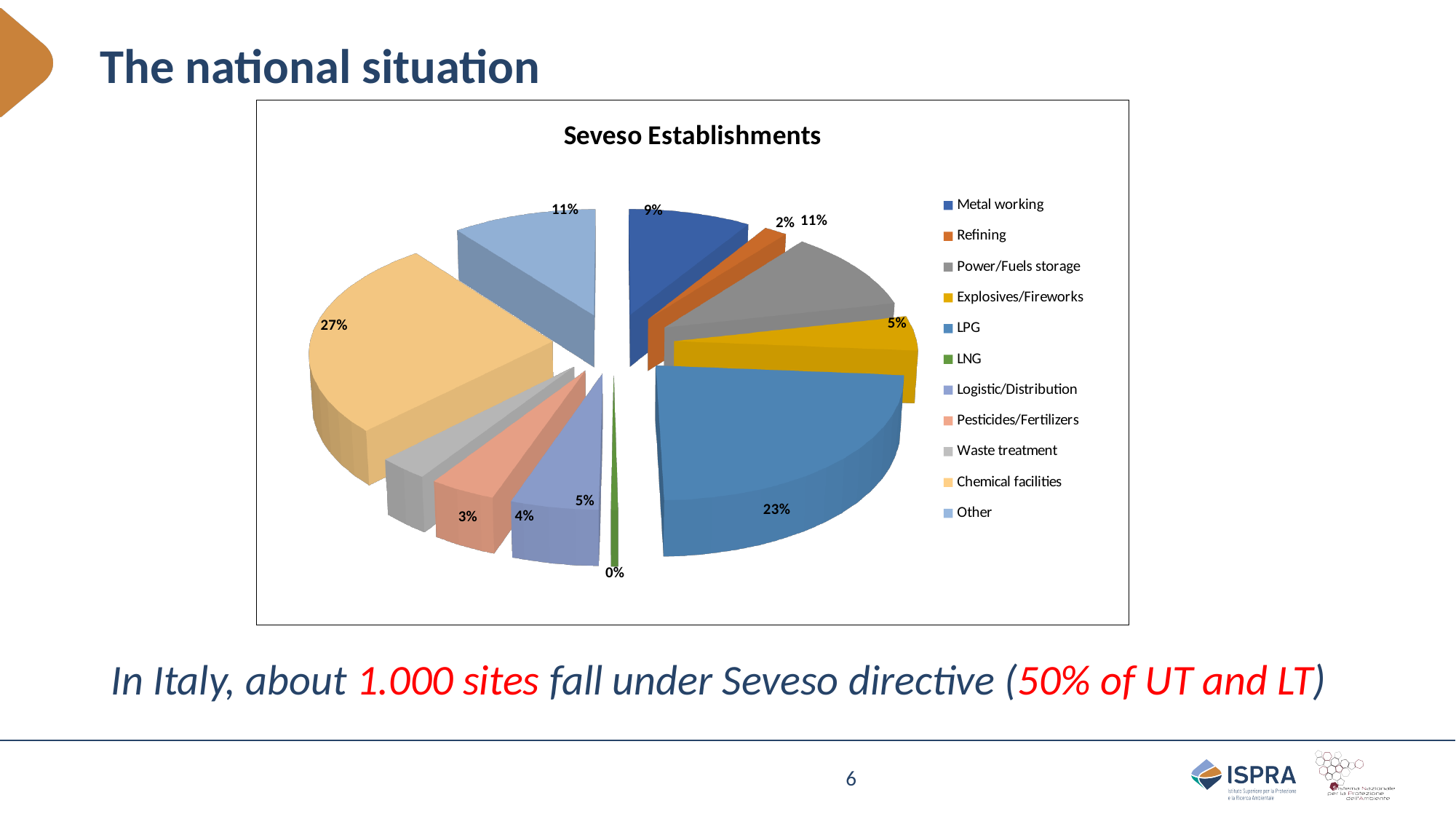
How many categories does the legend list? 11 What is the title of the chart? Seveso Establishments What kind of chart is shown on the slide? Pie chart What percentage is shown for Refining? 2% Which has a larger share, Power/Fuels storage or Pesticides/Fertilizers? Power/Fuels storage What share of Seveso establishments is LPG? 23% What is the difference in percentage points between Chemical facilities and LPG? 4 Which category has the largest share of the pie? Chemical facilities Which category has the smallest share of the pie? LNG What percentage is shown for Waste treatment? 3% What percentage is shown for Metal working? 9% What share of Seveso establishments is Chemical facilities? 27%